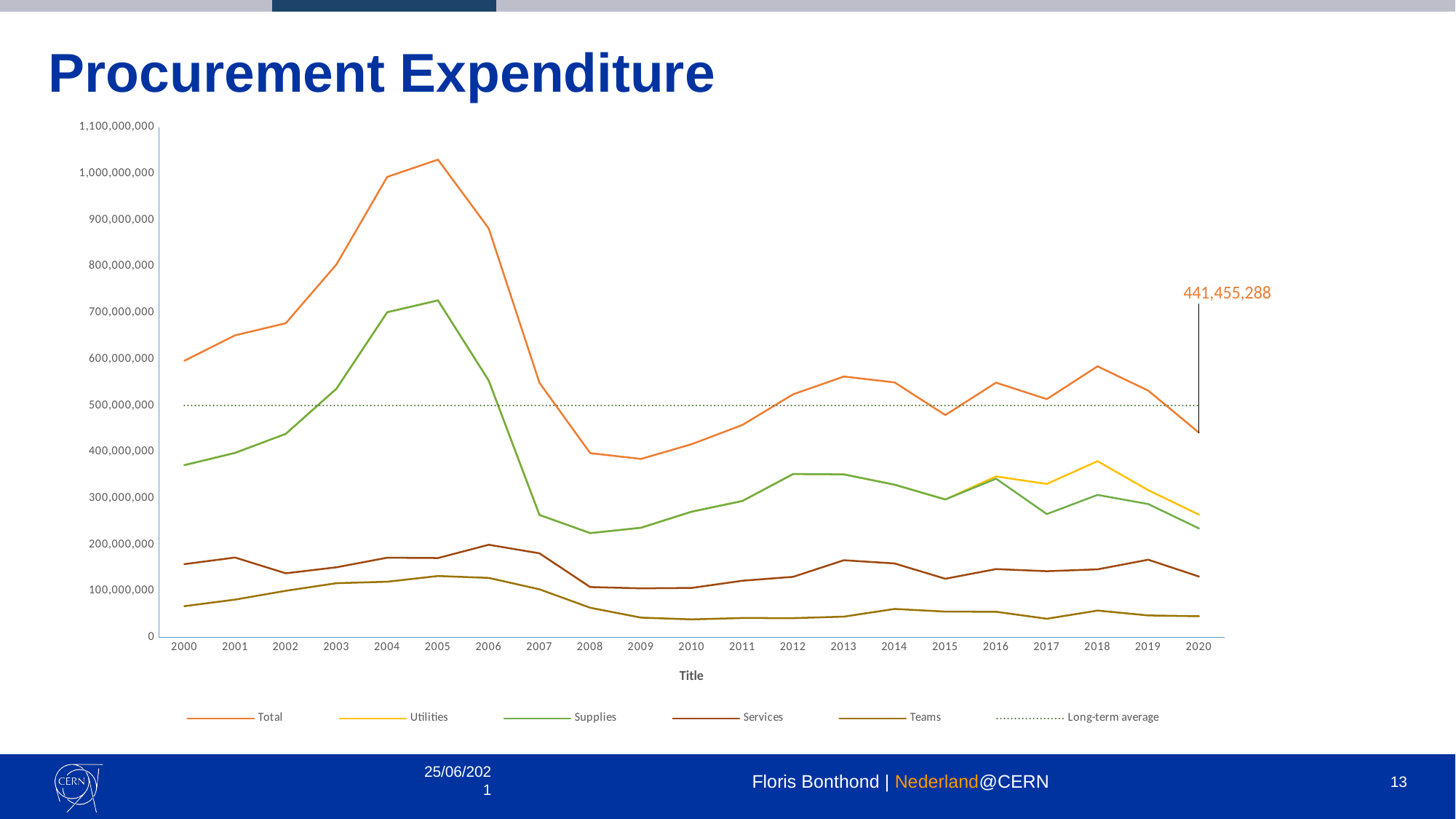
Which series has the lowest value in 2020? Teams Is the value of the Total series in 2000 greater or less than 500,000,000? greater What is the value of the Total series in 2020? 441,455,288 How many series does the legend list? 6 In 2005, which is larger: Supplies or Services? Supplies In which year does the Total series reach its highest value? 2005 What kind of chart is shown on the slide? line chart What is the label shown on the x axis of the chart? Title How many years are plotted along the x axis? 21 Is the value of the Total series in 2005 greater or less than 900,000,000? greater Does the Total series rise or fall between 2005 and 2008? fall